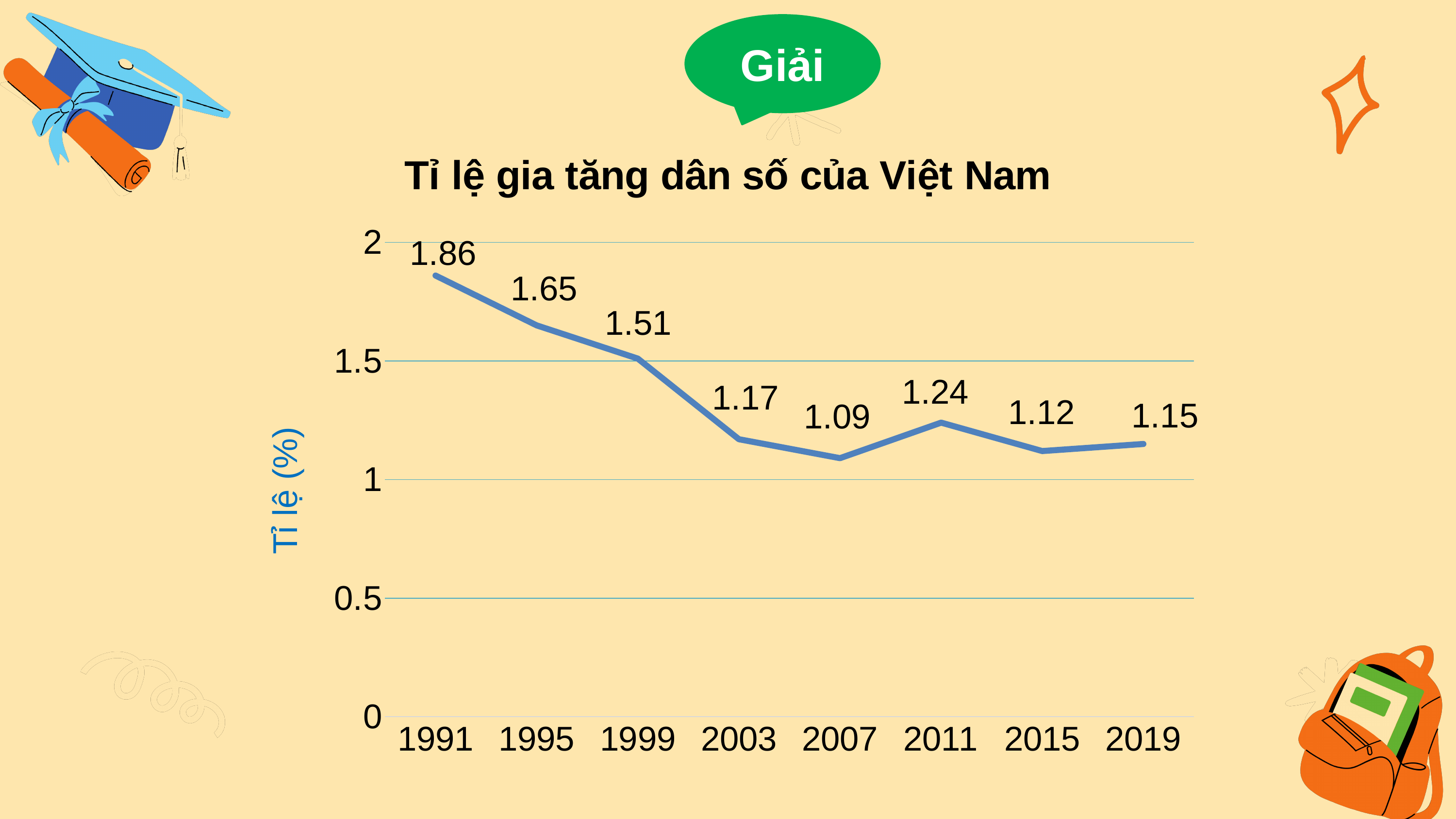
What is the title of the chart? Tỉ lệ gia tăng dân số của Việt Nam What is the difference between the values for 1991 and 2019? 0.71 What kind of chart is this? line chart Do the values rise or fall from 1991 to 2003? fall Is the value for 1999 greater or less than 1.5? greater What is the value for 2019? 1.15 Which year has the highest value? 1991 Which year has the lowest value? 2007 What is the value for 1991? 1.86 Which is larger, the value for 2011 or the value for 2015? 2011 How many years are plotted on the x axis? 8 What is the value for 2007? 1.09